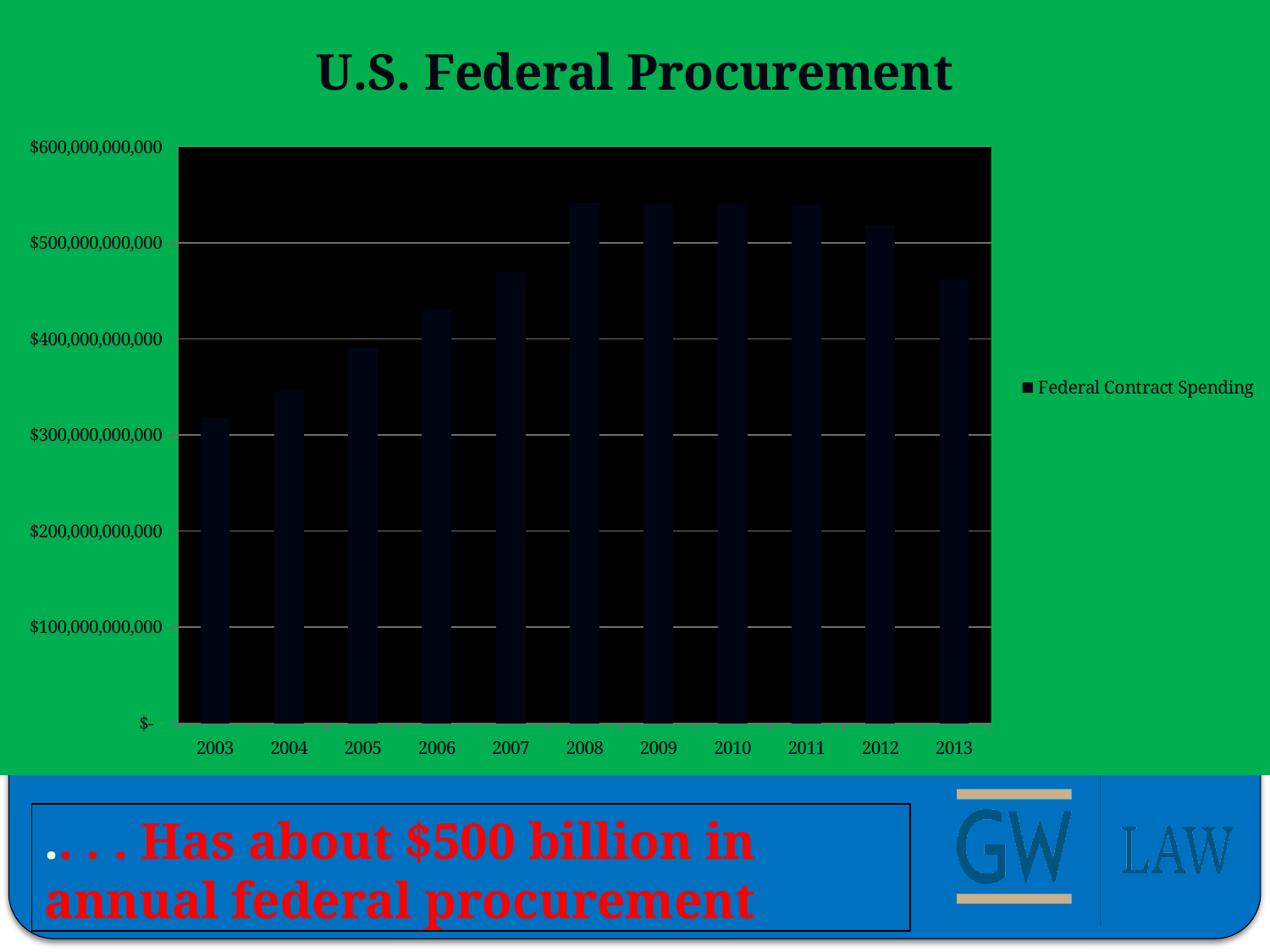
Which year has the larger Federal Contract Spending, 2003 or 2013? 2013 What is the title of the chart? U.S. Federal Procurement Does Federal Contract Spending rise or fall from 2003 to 2008? rise What is the name of the series shown in the chart's legend? Federal Contract Spending Which year has the lowest Federal Contract Spending? 2003 Is the value for 2013 greater or less than $500,000,000,000? less What kind of chart is shown on the slide? bar chart Is the value for 2008 greater or less than $500,000,000,000? greater Is the value for 2003 greater or less than $300,000,000,000? greater How many years are plotted on the x axis of the chart? 11 How many series does the chart's legend list? 1